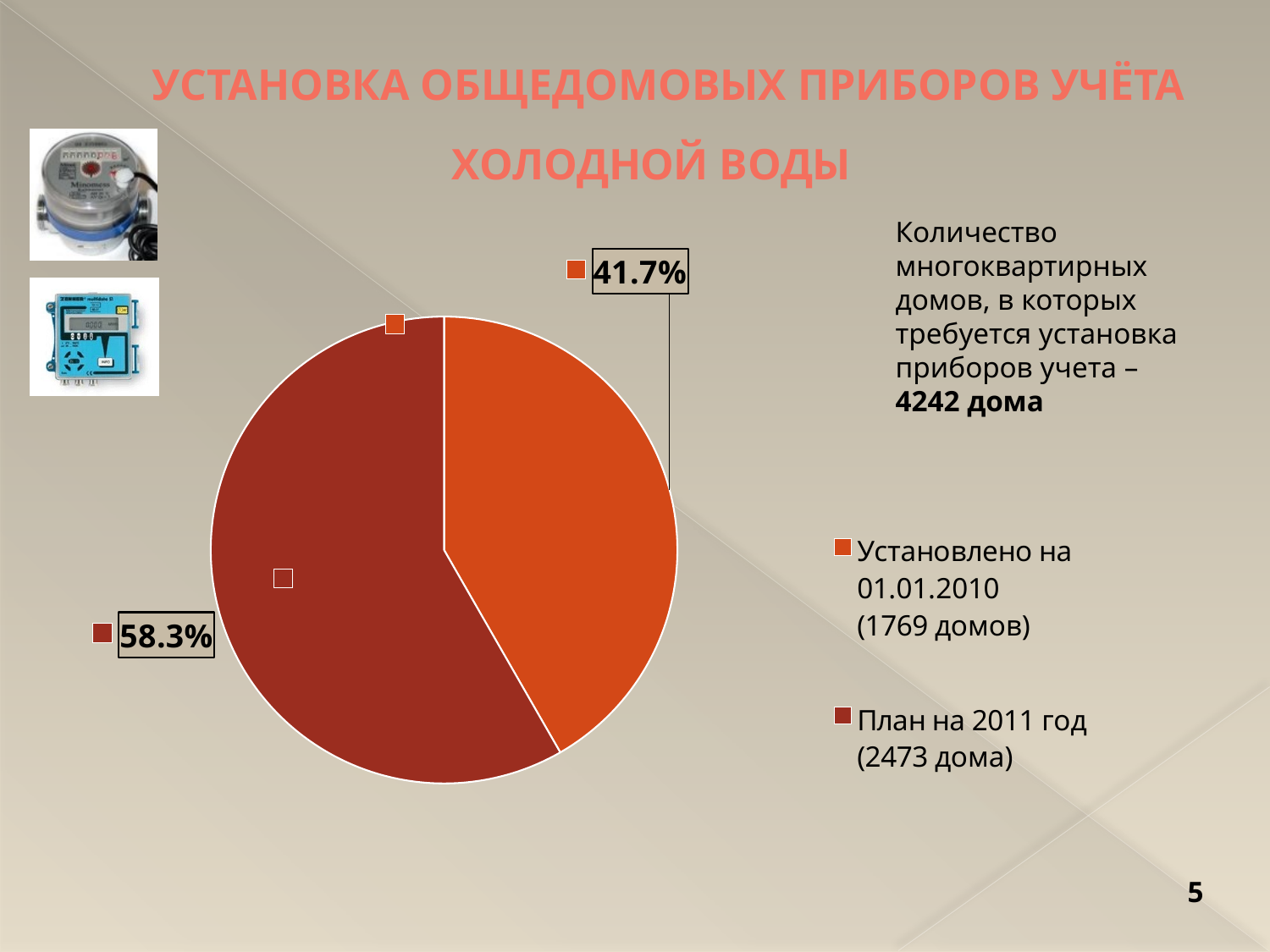
What colour is the slice labelled 58.3%? dark red What kind of chart is shown on the slide? pie chart What share of the pie does "Установлено на 01.01.2010 (1769 домов)" represent? 41.7% How many houses are given in the legend for "Установлено на 01.01.2010"? 1769 домов Which slice of the pie chart is the smallest? Установлено на 01.01.2010 (1769 домов) What is the difference in percentage points between the "План на 2011 год" slice and the "Установлено на 01.01.2010" slice? 16.6 What share of the pie does "План на 2011 год (2473 дома)" represent? 58.3% How many slices does the pie chart have? 2 Which is larger: the share for "Установлено на 01.01.2010" or the share for "План на 2011 год"? План на 2011 год How many houses are given in the legend for "План на 2011 год"? 2473 дома Which slice of the pie chart is the largest? План на 2011 год (2473 дома) How many entries does the legend of the pie chart list? 2